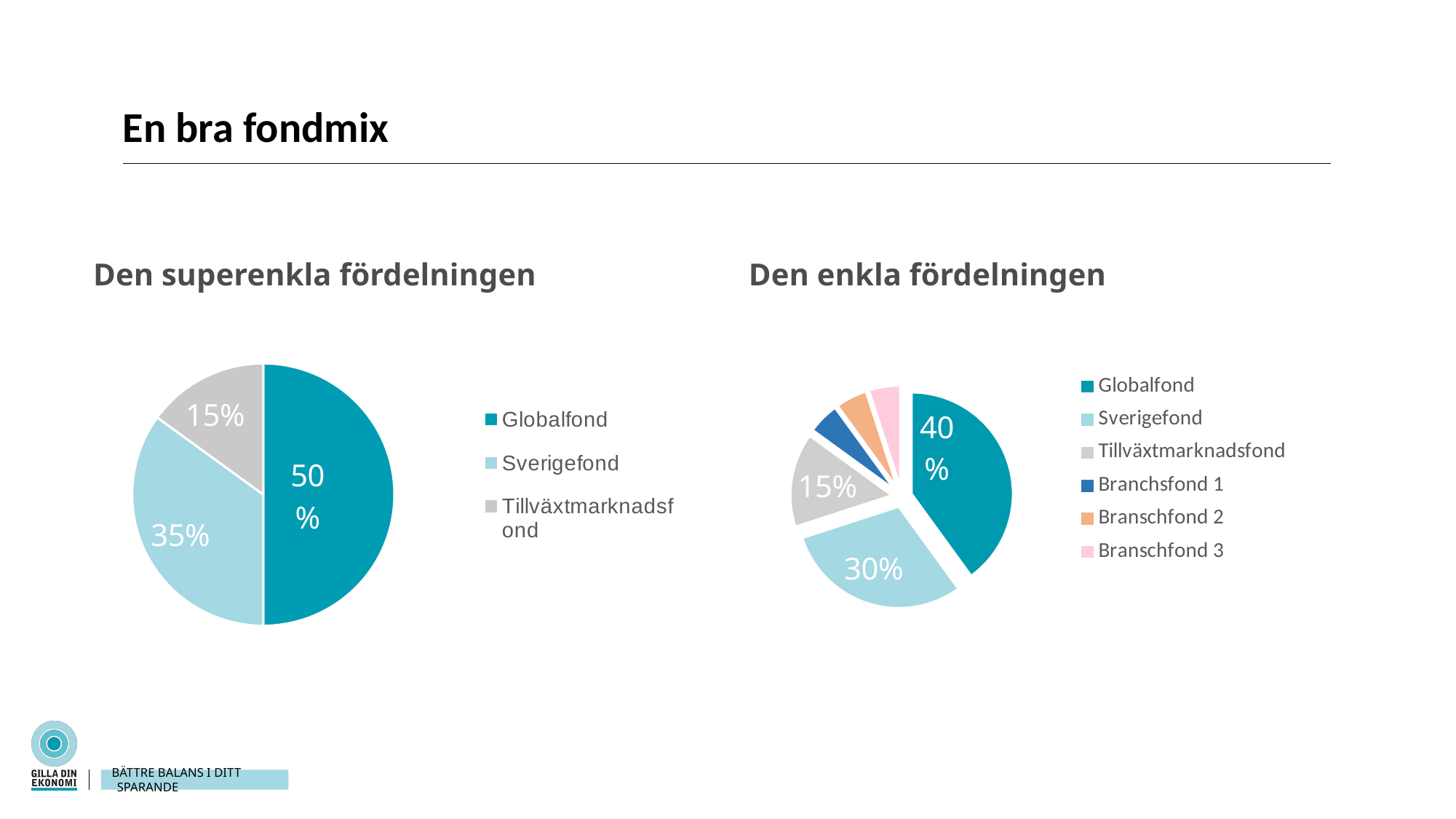
In the chart titled "Den superenkla fördelningen", what share does Tillväxtmarknadsfond have? 15% In the chart titled "Den superenkla fördelningen", what share does Globalfond have? 50% In the chart titled "Den enkla fördelningen", what share does Globalfond have? 40% In the chart titled "Den superenkla fördelningen", which fund has the largest slice? Globalfond How many entries does the legend of the chart titled "Den enkla fördelningen" list? 6 In the chart titled "Den superenkla fördelningen", which fund has the smallest slice? Tillväxtmarknadsfond In the chart titled "Den enkla fördelningen", which fund has the largest slice? Globalfond In the chart titled "Den superenkla fördelningen", what is the difference between the Globalfond and Sverigefond shares? 15% In the chart titled "Den enkla fördelningen", which is larger, the Sverigefond slice or the Tillväxtmarknadsfond slice? Sverigefond What type of chart is the chart titled "Den superenkla fördelningen"? Pie chart In the chart titled "Den enkla fördelningen", what share does Sverigefond have? 30% In the chart titled "Den superenkla fördelningen", what share does Sverigefond have? 35%